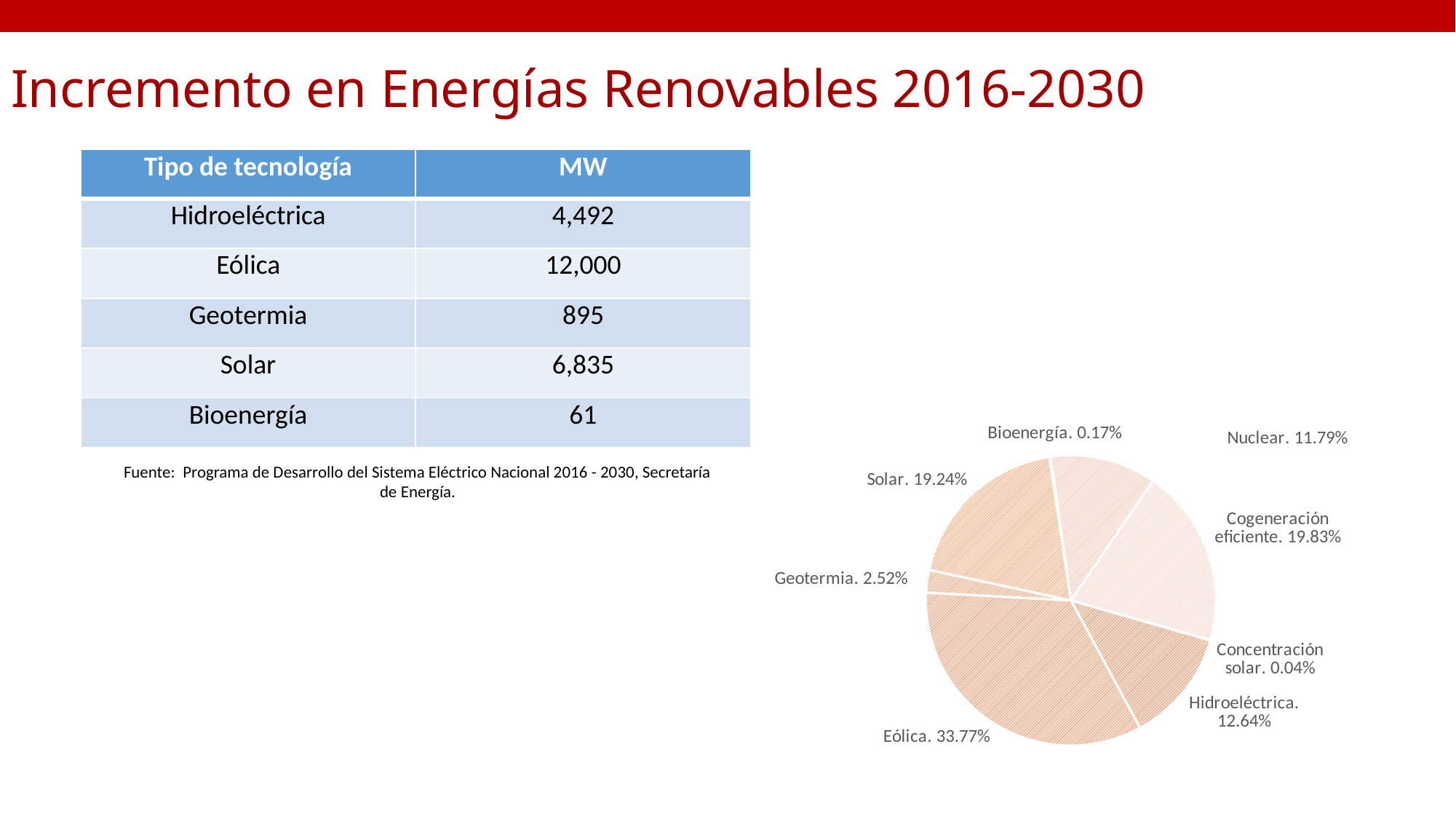
Which slice of the pie chart is the largest? Eólica Which slice of the pie chart is the smallest? Concentración solar In the pie chart, what share does Nuclear have? 11.79% In the pie chart, what share does Cogeneración eficiente have? 19.83% In the pie chart, what share does Geotermia have? 2.52% In the pie chart, which is larger: Nuclear or Hidroeléctrica? Hidroeléctrica In the pie chart, what is the difference in percentage points between Cogeneración eficiente and Solar? 0.59 In the pie chart, what share does Eólica have? 33.77% In the pie chart, what is the difference in percentage points between Eólica and Solar? 14.53 How many slices does the pie chart have? 8 In the pie chart, what share does Concentración solar have? 0.04% What kind of chart is shown on the slide? pie chart